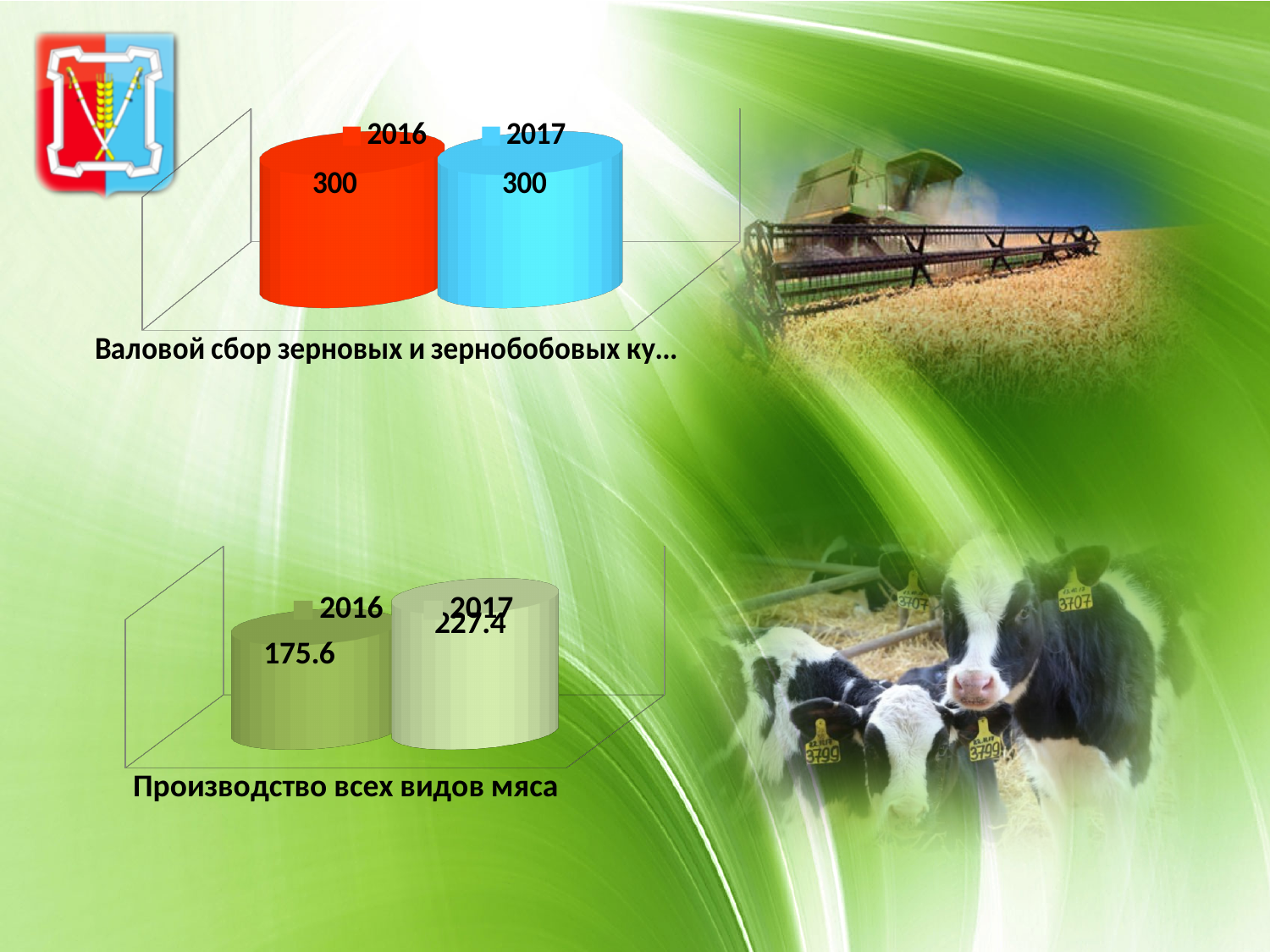
In the bottom chart (Производство всех видов мяса), what is the value for 2016? 175.6 In the bottom chart (Производство всех видов мяса), what is the value for 2017? 227.4 In the top chart (Валовой сбор зерновых и зернобобовых ку...), how many series does the legend list? 2 In the bottom chart (Производство всех видов мяса), is the value for 2017 larger than the value for 2016? Yes In the bottom chart (Производство всех видов мяса), how many bars are plotted? 2 In the bottom chart (Производство всех видов мяса), which year has the higher value? 2017 In the top chart (Валовой сбор зерновых и зернобобовых ку...), what is the value for 2017? 300 In the bottom chart (Производство всех видов мяса), what is the difference between the 2017 and 2016 values? 51.8 What kind of chart is the bottom chart (Производство всех видов мяса)? Bar chart In the top chart (Валовой сбор зерновых и зернобобовых ку...), what is the difference between the 2017 and 2016 values? 0 In the bottom chart (Производство всех видов мяса), which year has the lower value? 2016 In the top chart (Валовой сбор зерновых и зернобобовых ку...), what is the value for 2016? 300